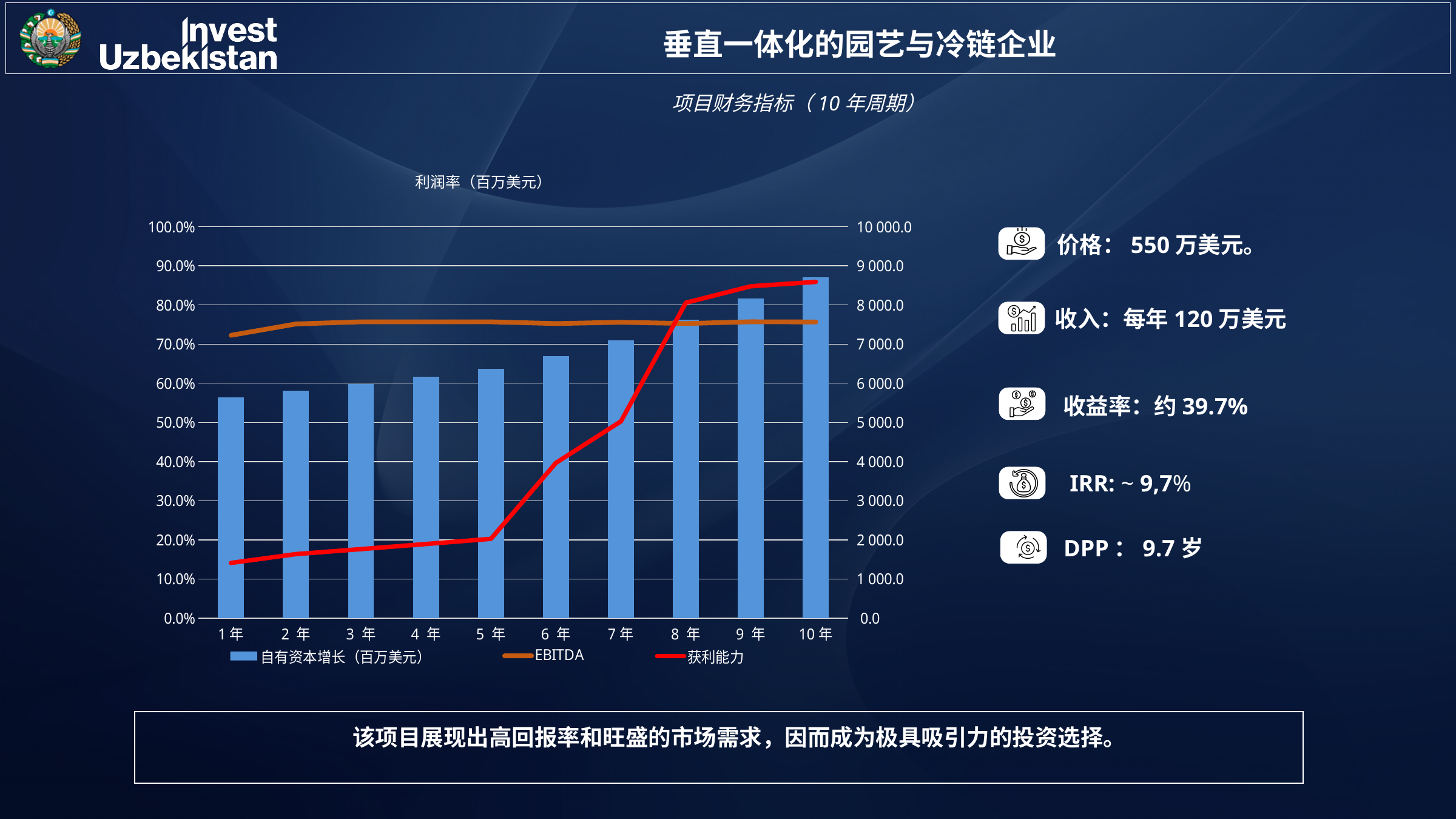
Reading against the left percentage axis, is the bar for 10 年 greater or less than 80.0%? greater What is the title of the chart? 利润率（百万美元） Reading against the left percentage axis, is the bar for 1 年 greater or less than 60.0%? less Which year has the shortest bar for 自有资本增长（百万美元）? 1 年 Which year has the tallest bar for 自有资本增长（百万美元）? 10 年 How many year categories are shown on the x axis of the chart? 10 How many series does the chart legend list? 3 Do the bars for 自有资本增长（百万美元）rise or fall from 1 年 to 10 年? Rise What kind of chart is shown on the slide? A bar chart combined with line series Does the red 获利能力 line rise or fall from 1 年 to 10 年? Rise What is the highest tick label on the right-hand axis of the chart? 10 000.0 Which bar is taller, 1 年 or 10 年? 10 年